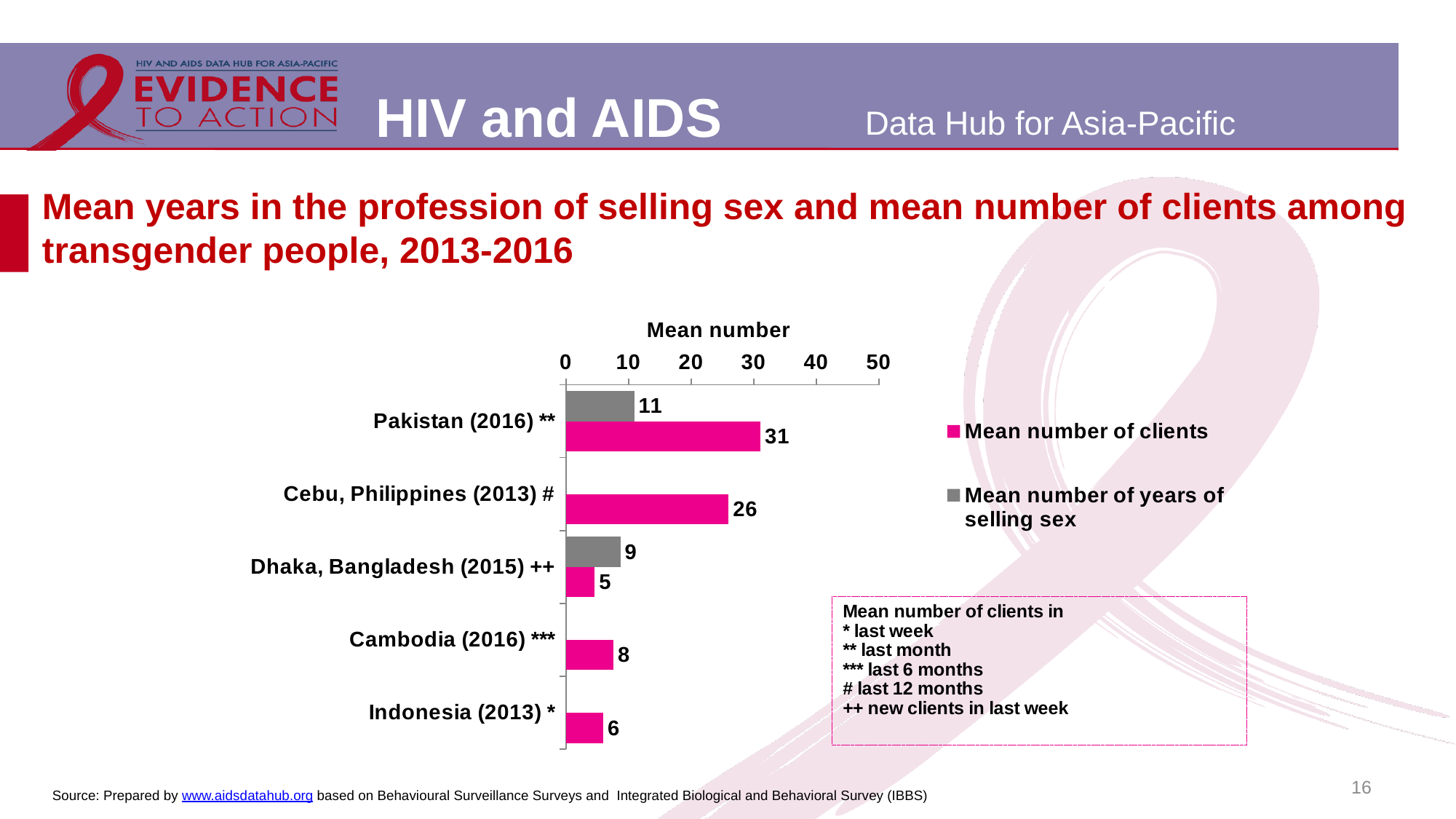
What is the mean number of years of selling sex for Dhaka, Bangladesh (2015) ++? 9 How many series does the legend list? 2 Which category has the highest mean number of clients? Pakistan (2016) ** What is the label of the x axis of the chart? Mean number What is the mean number of clients for Cebu, Philippines (2013) #? 26 What is the mean number of clients for Pakistan (2016) **? 31 Which category has the lowest mean number of clients? Dhaka, Bangladesh (2015) ++ Is the mean number of clients for Cebu, Philippines (2013) # greater or less than 20? greater What kind of chart is shown on the slide? Bar chart How many categories are shown on the y axis of the chart? 5 Which is larger for Dhaka, Bangladesh (2015) ++: the mean number of clients or the mean number of years of selling sex? Mean number of years of selling sex What is the difference between the mean number of clients and the mean number of years of selling sex for Pakistan (2016) **? 20